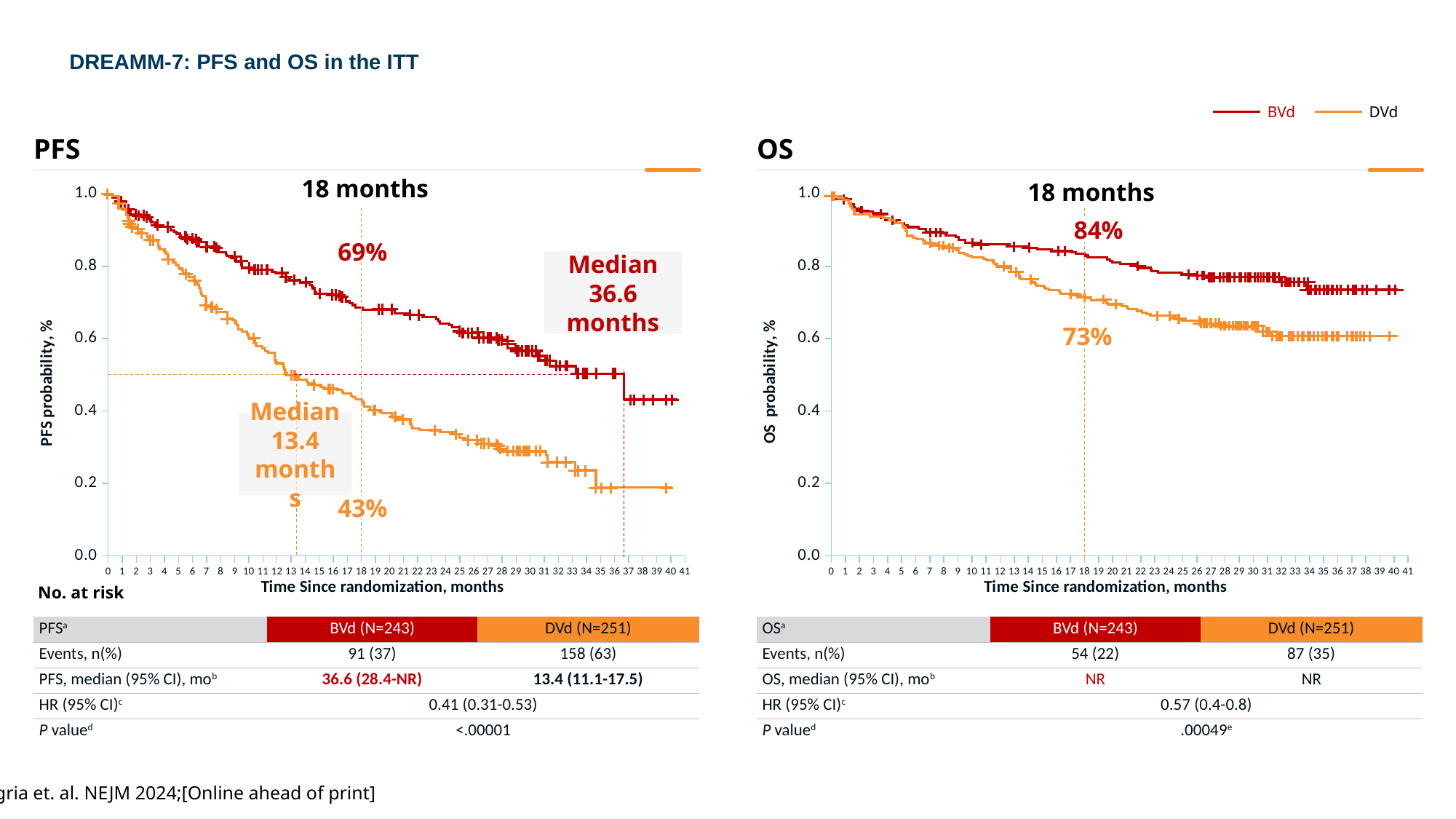
In the PFS chart, what is the median PFS for the BVd arm? 36.6 months In the OS chart, what is the OS probability for BVd at 18 months? 84% In the PFS chart, is the DVd PFS probability at 18 months greater or less than 0.6? less In the PFS chart, what is the PFS probability for DVd at 18 months? 43% How many series does the legend list? 2 In the OS chart, do the curves rise or fall as time since randomization increases? fall In the PFS chart, what is the PFS probability for BVd at 18 months? 69% In the OS chart, what is the difference between the BVd and DVd OS probabilities at 18 months? 11% In the PFS chart, what is the median PFS for the DVd arm? 13.4 months In the OS chart, what is the OS probability for DVd at 18 months? 73% In the PFS chart, what is the difference between the BVd and DVd PFS probabilities at 18 months? 26% In the OS chart, which arm has the higher OS probability at 18 months, BVd or DVd? BVd